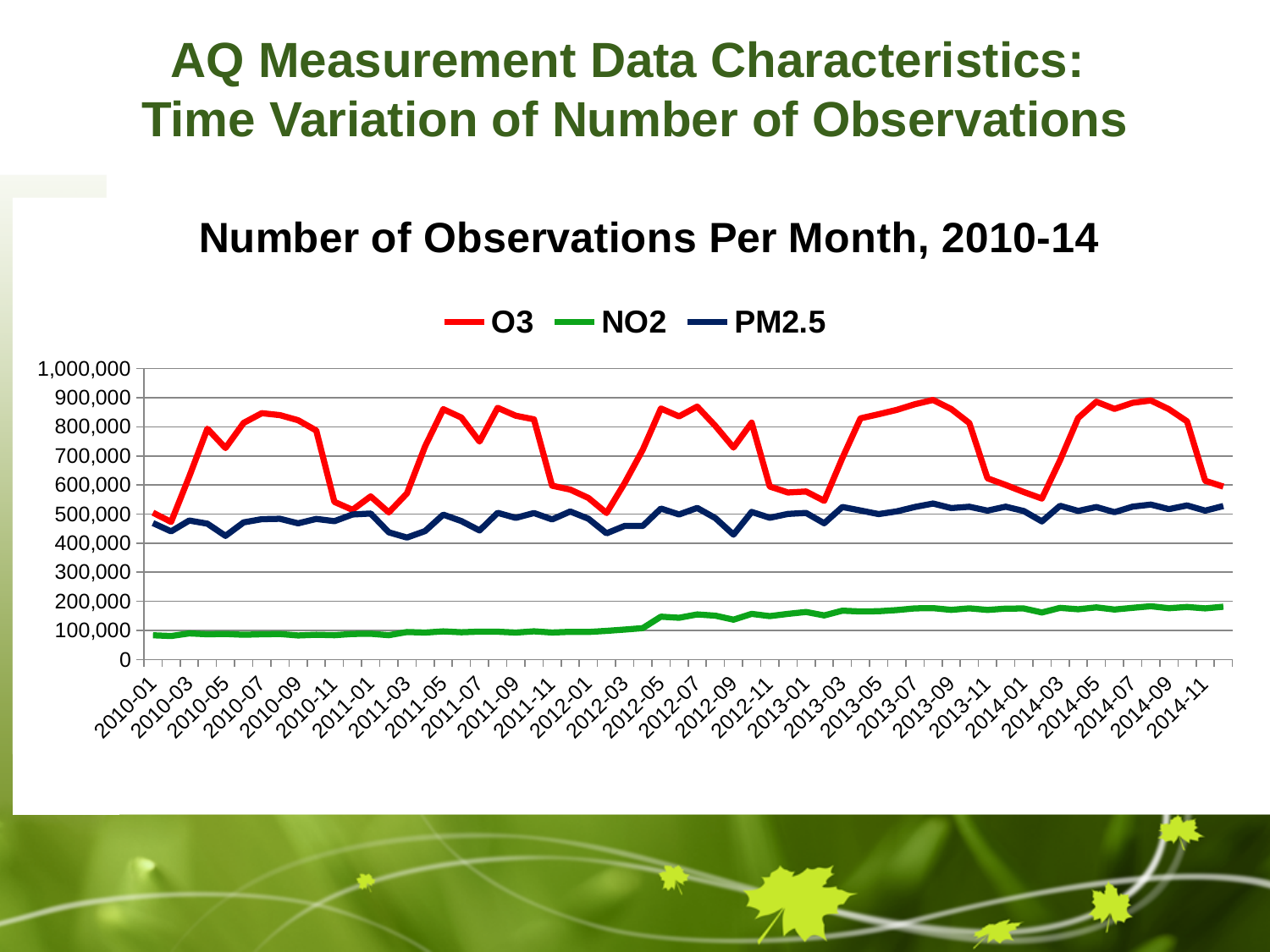
Is the value for NO2 at 2014-11 greater or less than 200,000? less What are the series names listed in the legend? O3, NO2, PM2.5 How many series does the legend list? 3 Is the value for O3 at 2010-11 greater or less than 600,000? less Does the NO2 series generally rise or fall from 2010-01 to 2014-11? rise Which series reaches the highest value on the chart? O3 What kind of chart is shown on the slide? Line chart At 2013-01, which is larger, PM2.5 or NO2? PM2.5 What is the title of the chart? Number of Observations Per Month, 2010-14 Is the value for O3 at 2010-07 greater or less than 800,000? greater Which series has the lowest values throughout the chart? NO2